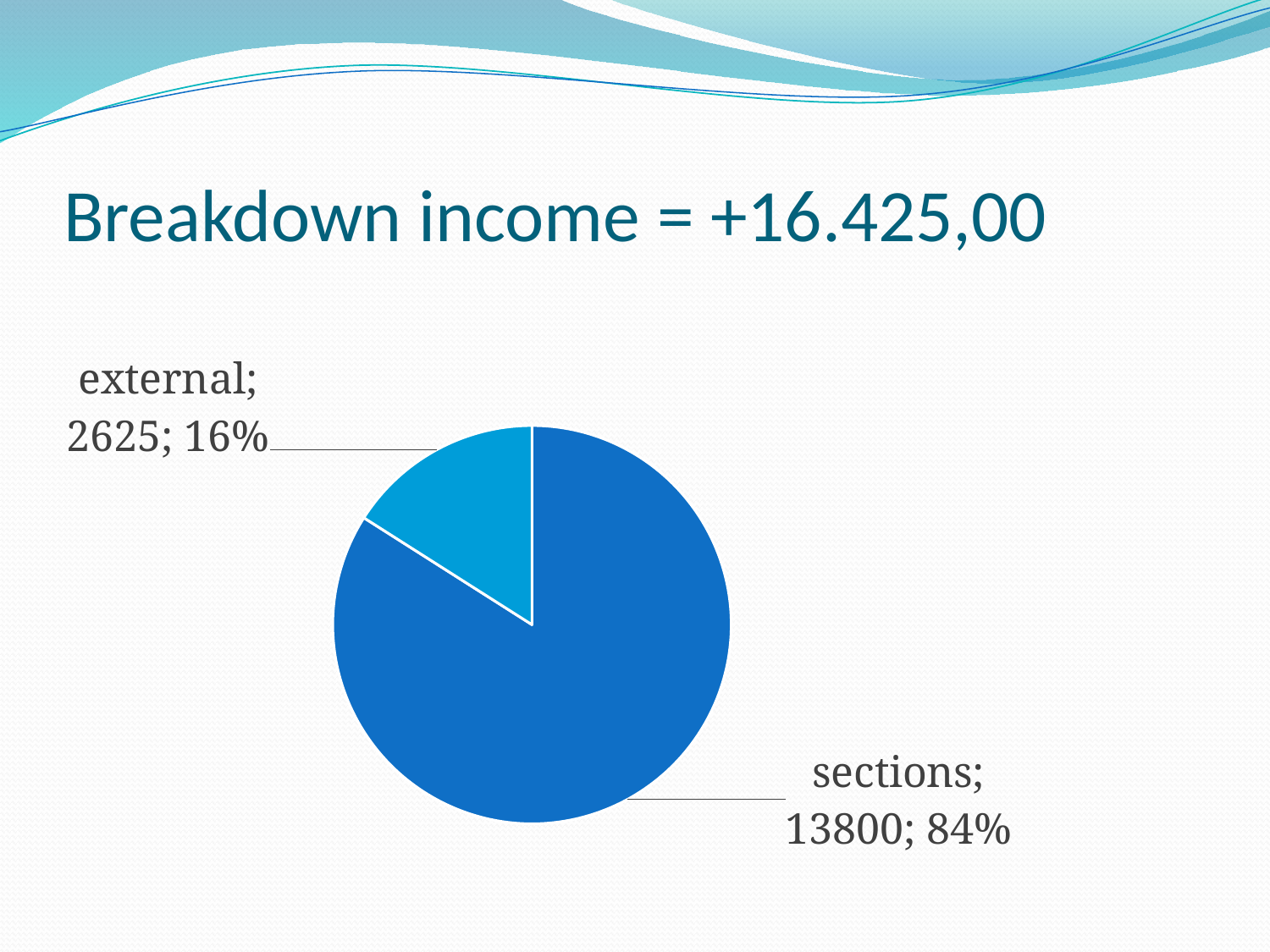
How many slices does the pie chart have? 2 Which is larger, the value for sections or the value for external? sections What type of chart is shown on the slide? pie chart Which category has the largest slice? sections Which category has the smallest slice? external What is the value for external? 2625 What share of the pie does the sections slice represent? 84% What is the total of the two slices in the pie chart? 16425 What is the difference between the values for sections and external? 11175 What is the title of the slide containing the chart? Breakdown income = +16.425,00 What is the value for sections? 13800 What share of the pie does the external slice represent? 16%